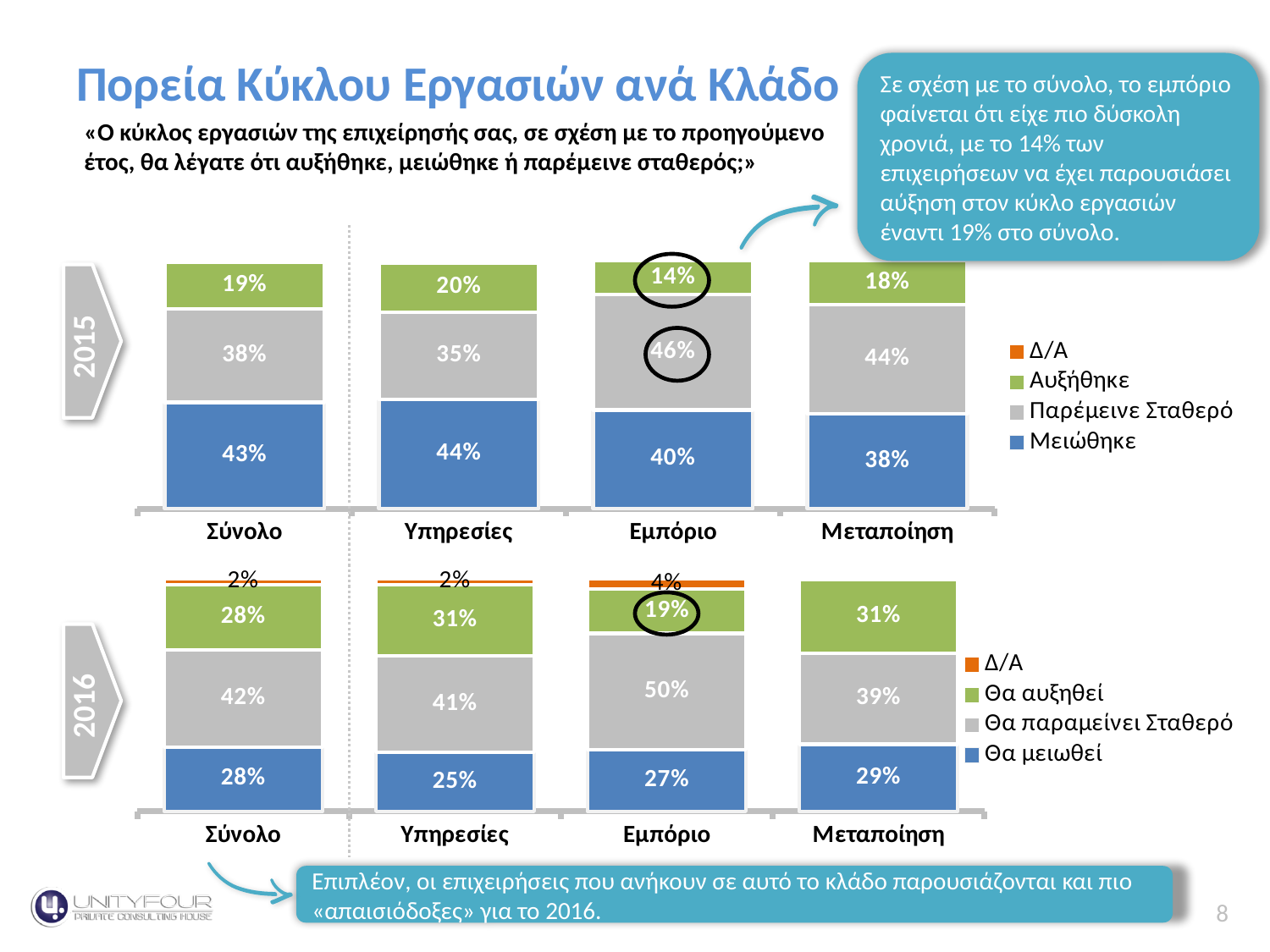
In the 2015 chart, which category has the highest Παρέμεινε Σταθερό value? Εμπόριο In the 2016 chart, what is the value of Θα παραμείνει Σταθερό for Εμπόριο? 50% In the 2016 chart, what is the value of Δ/Α for Εμπόριο? 4% In the 2015 chart, what is the value of Μειώθηκε for Υπηρεσίες? 44% In the 2016 chart, which category has the lowest Θα αυξηθεί value? Εμπόριο How many categories are shown on the x axis of the 2016 chart? 4 What type of chart is the 2015 chart? Stacked bar chart In the 2015 chart, which category has the lowest Αυξήθηκε value? Εμπόριο In the 2015 chart, what is the difference between the Αυξήθηκε values for Σύνολο and Εμπόριο? 5% In the 2016 chart, is the Θα μειωθεί value for Υπηρεσίες larger or smaller than that for Μεταποίηση? smaller In the 2015 chart, what is the value of Αυξήθηκε for Εμπόριο? 14% How many series does the legend of the 2015 chart list? 4